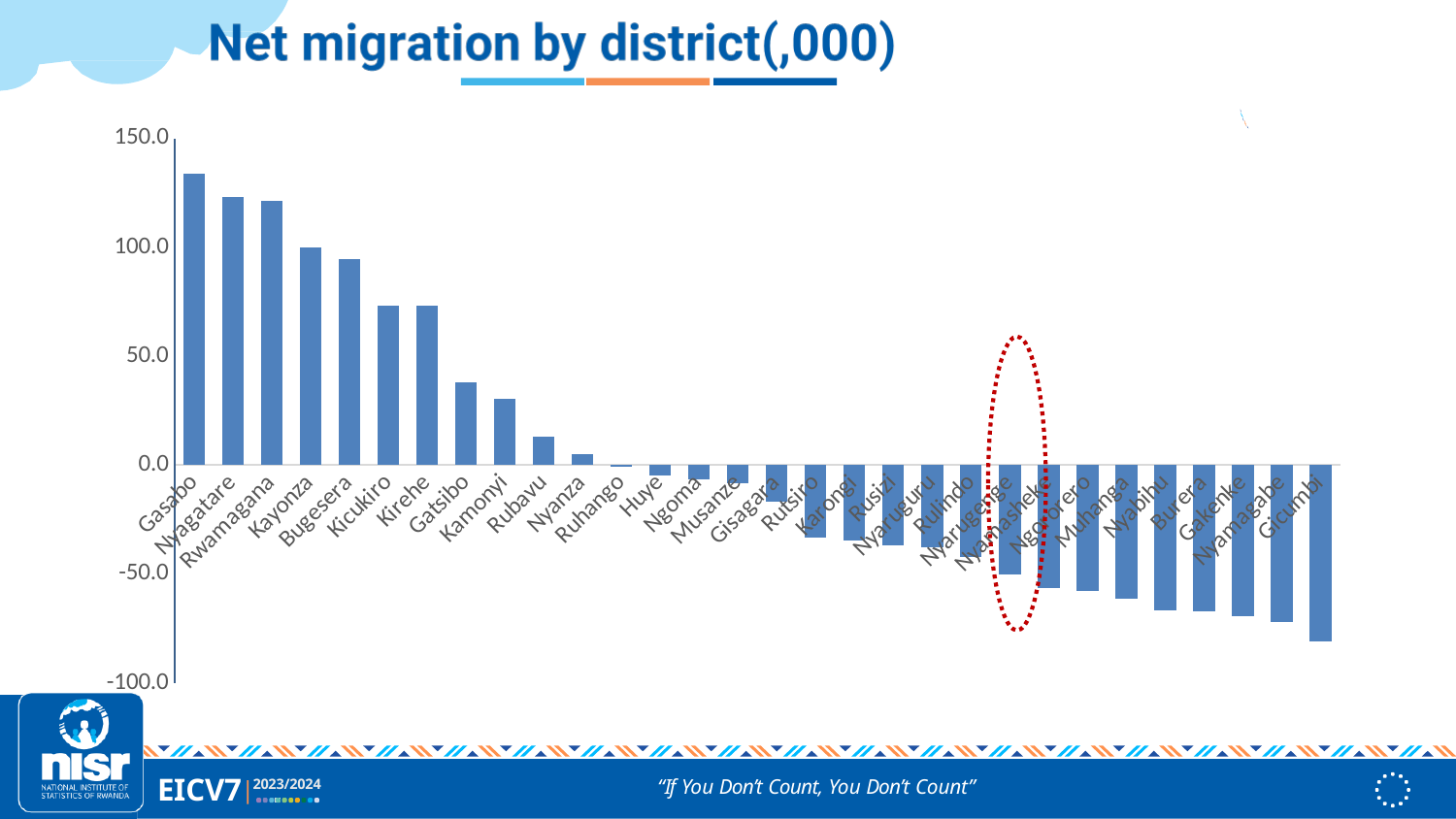
Which district has the lowest net migration? Gicumbi Is the value for Gicumbi greater or less than -50.0? less Do the values rise or fall moving from left to right along the x axis? fall What kind of chart is shown on the slide? bar chart Which district has the larger net migration, Gatsibo or Kamonyi? Gatsibo Is the value for Bugesera greater or less than 50.0? greater Which district has the highest net migration? Gasabo Is the value for Gasabo greater or less than 100.0? greater Which district has the larger net migration, Gasabo or Kayonza? Gasabo What is the title of the chart? Net migration by district(,000) How many districts are plotted in the chart? 30